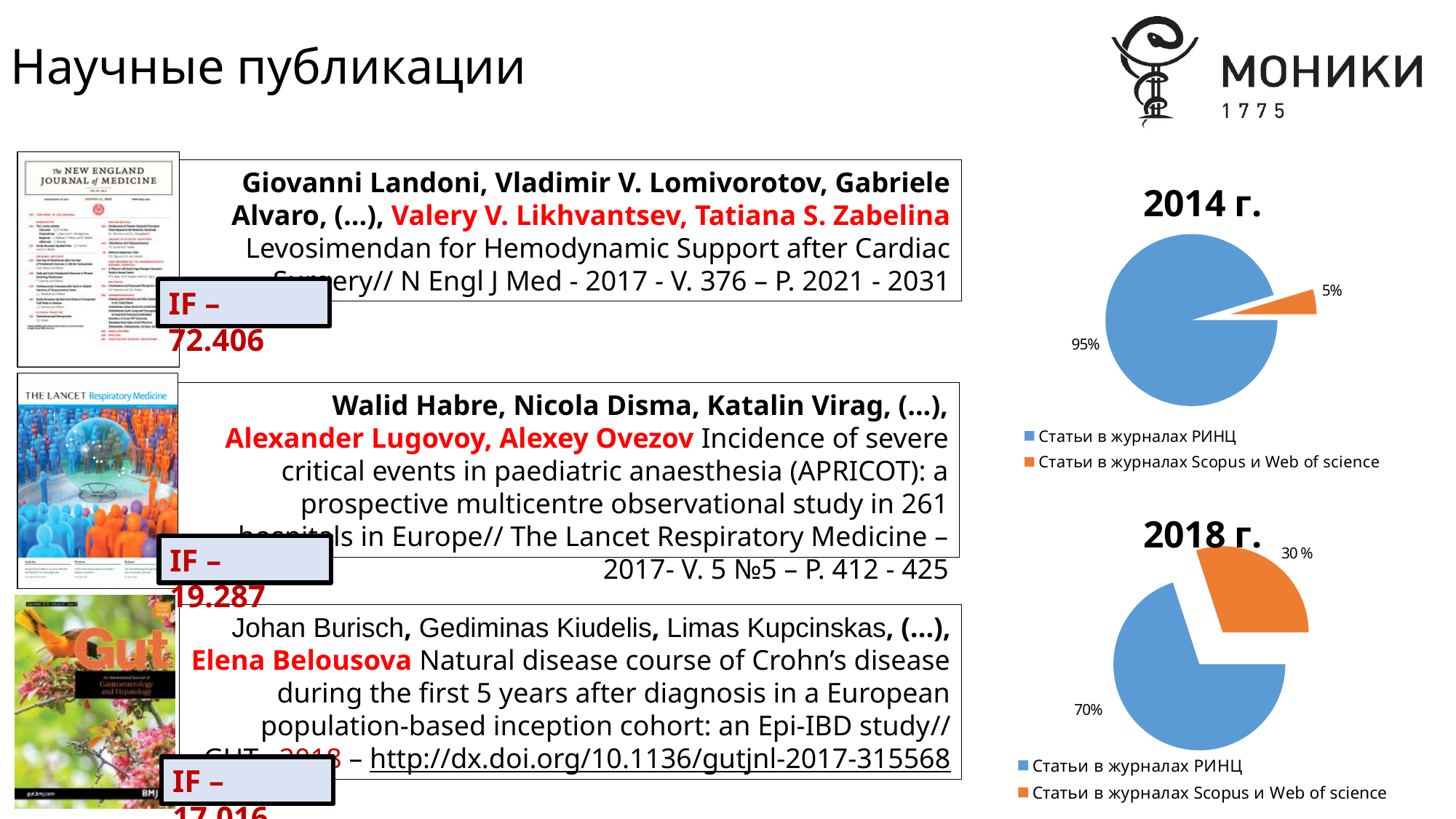
How many categories does the legend of the 2018 г. pie chart list? 2 In the 2018 г. pie chart, what share is labelled for Статьи в журналах Scopus и Web of science? 30 % In the 2018 г. pie chart, what is the difference in percentage points between the РИНЦ slice and the Scopus и Web of science slice? 40 In the 2014 г. pie chart, what share is labelled for Статьи в журналах РИНЦ? 95% In the 2018 г. pie chart, what share is labelled for Статьи в журналах РИНЦ? 70% How many pie charts are shown on the slide? 2 What type of chart is used for the 2014 г. data? Pie chart In the 2014 г. pie chart, what colour is the slice for Статьи в журналах Scopus и Web of science? Orange In the 2018 г. pie chart, which category has the smallest slice? Статьи в журналах Scopus и Web of science In the 2014 г. pie chart, which category has the largest slice? Статьи в журналах РИНЦ Comparing the two pie charts, is the Scopus и Web of science share larger in 2014 г. or in 2018 г.? 2018 г. In the 2014 г. pie chart, what share is labelled for Статьи в журналах Scopus и Web of science? 5%